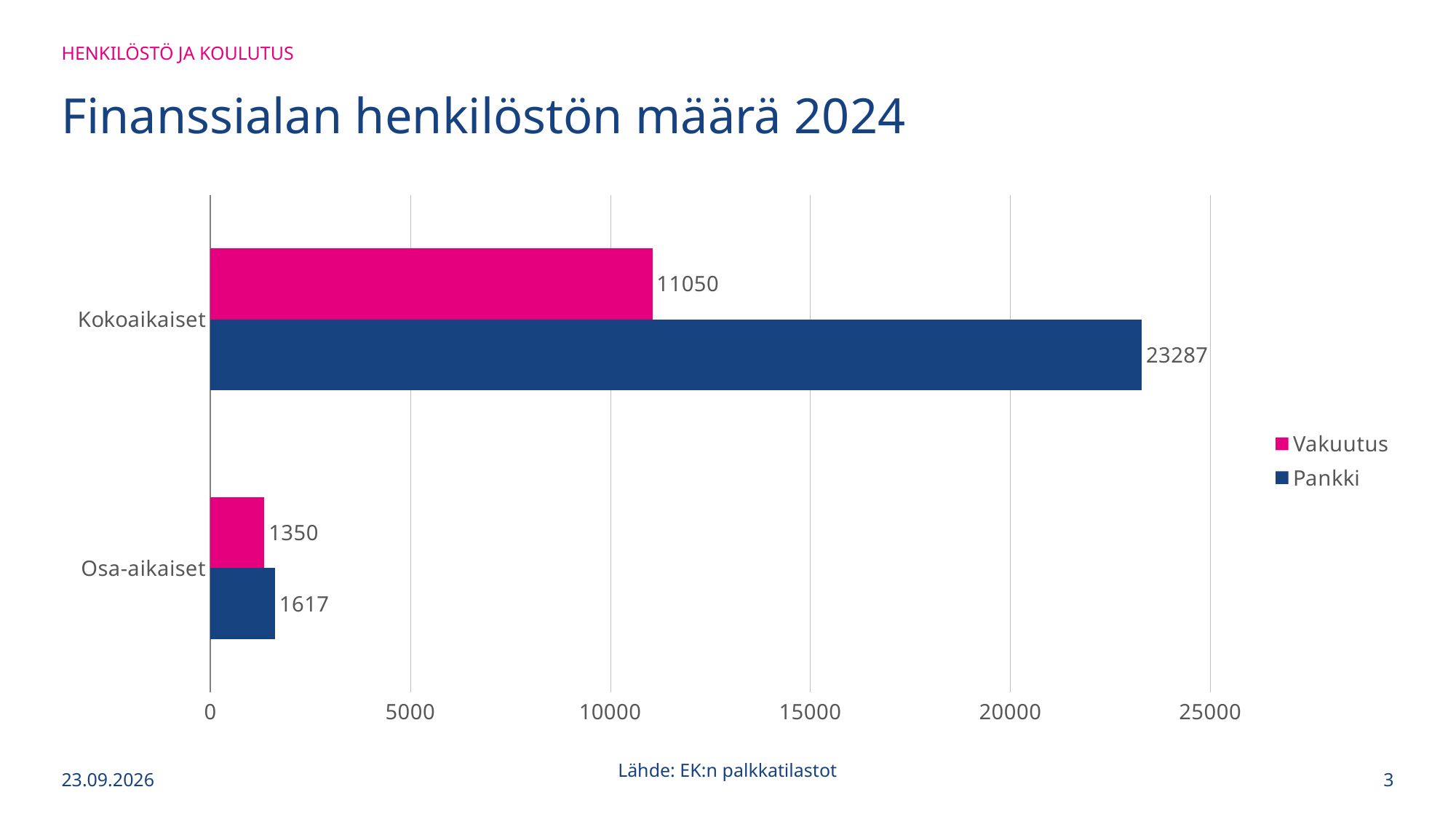
What is the value for Vakuutus in the Osa-aikaiset category? 1350 What is the value for Vakuutus in the Kokoaikaiset category? 11050 How many categories are shown on the chart? 2 What is the difference between the Pankki and Vakuutus values for Osa-aikaiset? 267 What is the value for Pankki in the Kokoaikaiset category? 23287 What is the value for Pankki in the Osa-aikaiset category? 1617 Which series has the lowest value in the Osa-aikaiset category? Vakuutus What is the difference between the Pankki and Vakuutus values for Kokoaikaiset? 12237 What kind of chart is shown on the slide? Bar chart Which series has the highest value in the Kokoaikaiset category? Pankki Which is larger: the Vakuutus value for Kokoaikaiset or the Pankki value for Osa-aikaiset? Vakuutus value for Kokoaikaiset How many series does the legend list? 2